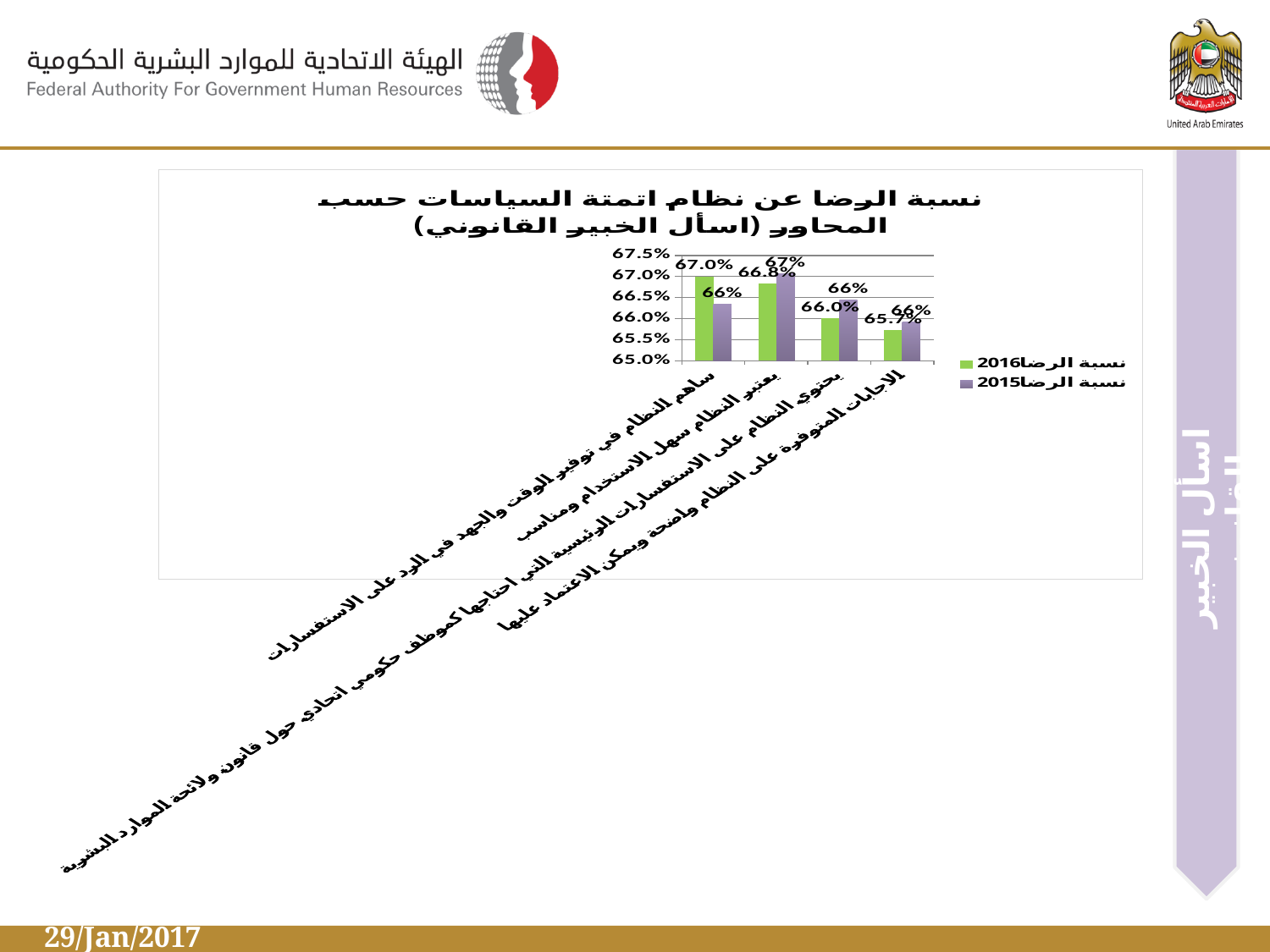
Which category has the lowest 2016 satisfaction value (نسبة الرضا2016)? الاجابات المتوفرة على النظام واضحة ويمكن الاعتماد عليها What is the 2016 satisfaction value (نسبة الرضا2016) for the last category, 'الاجابات المتوفرة على النظام واضحة ويمكن الاعتماد عليها'? 65.7% How many categories are plotted on the x axis of the chart? 4 Which category has the highest 2016 satisfaction value (نسبة الرضا2016)? ساهم النظام في توفير الوقت والجهد في الرد على الاستفسارات What is the difference between the highest and lowest 2016 satisfaction values (67.0% and 65.7%)? 1.3 percentage points Is the 2016 satisfaction value for the first category, 'ساهم النظام في توفير الوقت والجهد في الرد على الاستفسارات', greater or less than 66.5%? greater For the second category, 'يعتبر النظام سهل الاستخدام ومناسب', which series has the larger value: نسبة الرضا2016 or نسبة الرضا2015? نسبة الرضا2015 What is the 2016 satisfaction value (نسبة الرضا2016) for the first category, 'ساهم النظام في توفير الوقت والجهد في الرد على الاستفسارات'? 67.0% What are the two entries listed in the chart legend? نسبة الرضا2016 and نسبة الرضا2015 What type of chart is shown on the slide? Bar chart What is the 2016 satisfaction value (نسبة الرضا2016) for the second category, 'يعتبر النظام سهل الاستخدام ومناسب'? 66.8% How many series does the chart legend list? 2